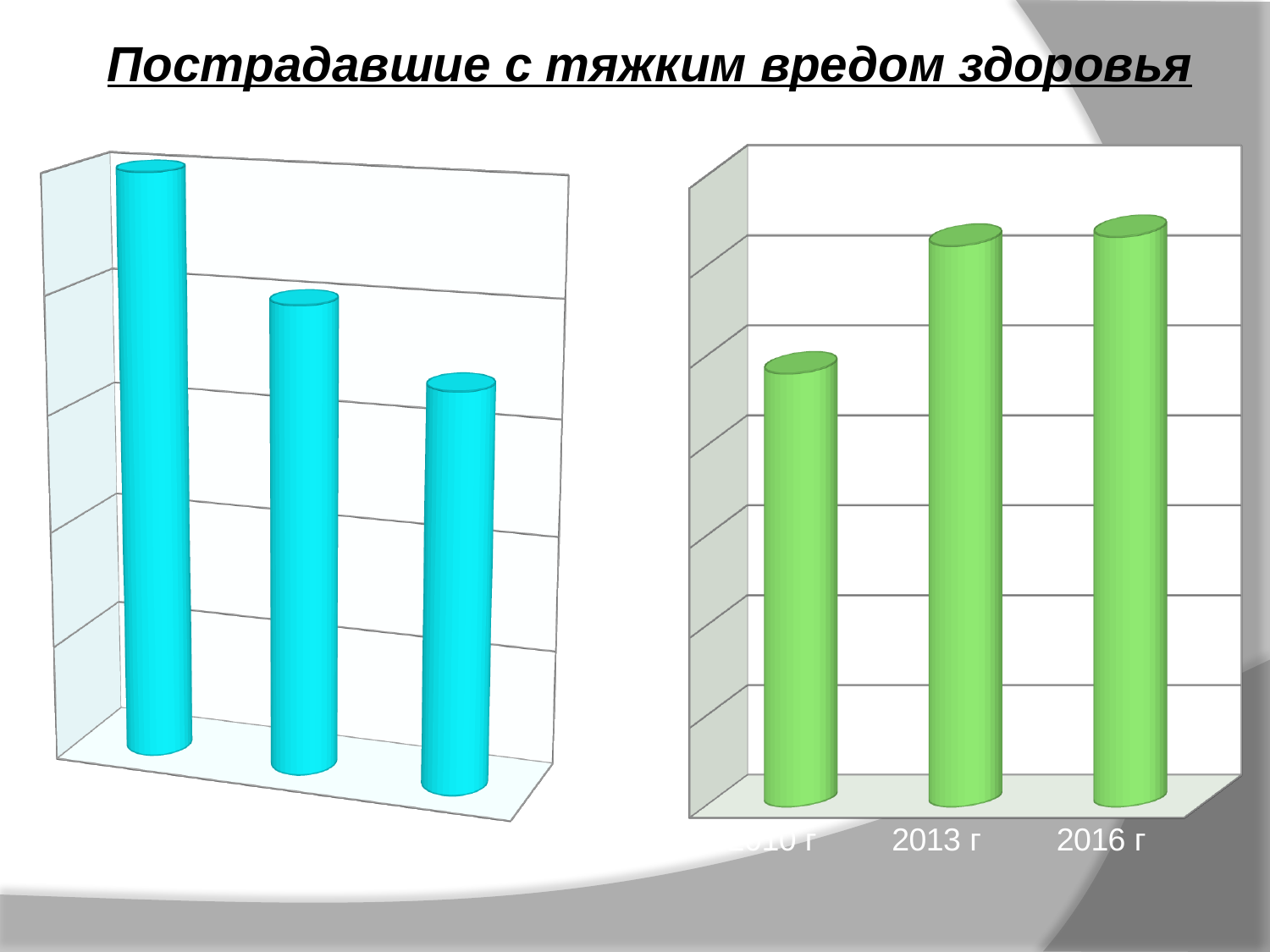
How many bars does the left chart have? 3 In the left chart, which bar is the tallest? the leftmost bar How many bars does the right chart have? 3 In the right chart, which category has the lowest value? the leftmost bar (2010 г) In the right chart, is the value for 2013 г larger or smaller than the value for the leftmost bar? larger What is the title of the slide? Пострадавшие с тяжким вредом здоровья How many charts are on the slide? 2 What kind of chart is the left chart? bar chart What colour are the bars in the right chart? green What kind of chart is the right chart? bar chart In the left chart, do the values rise or fall from left to right? fall In the right chart, do the values rise or fall from left to right? rise